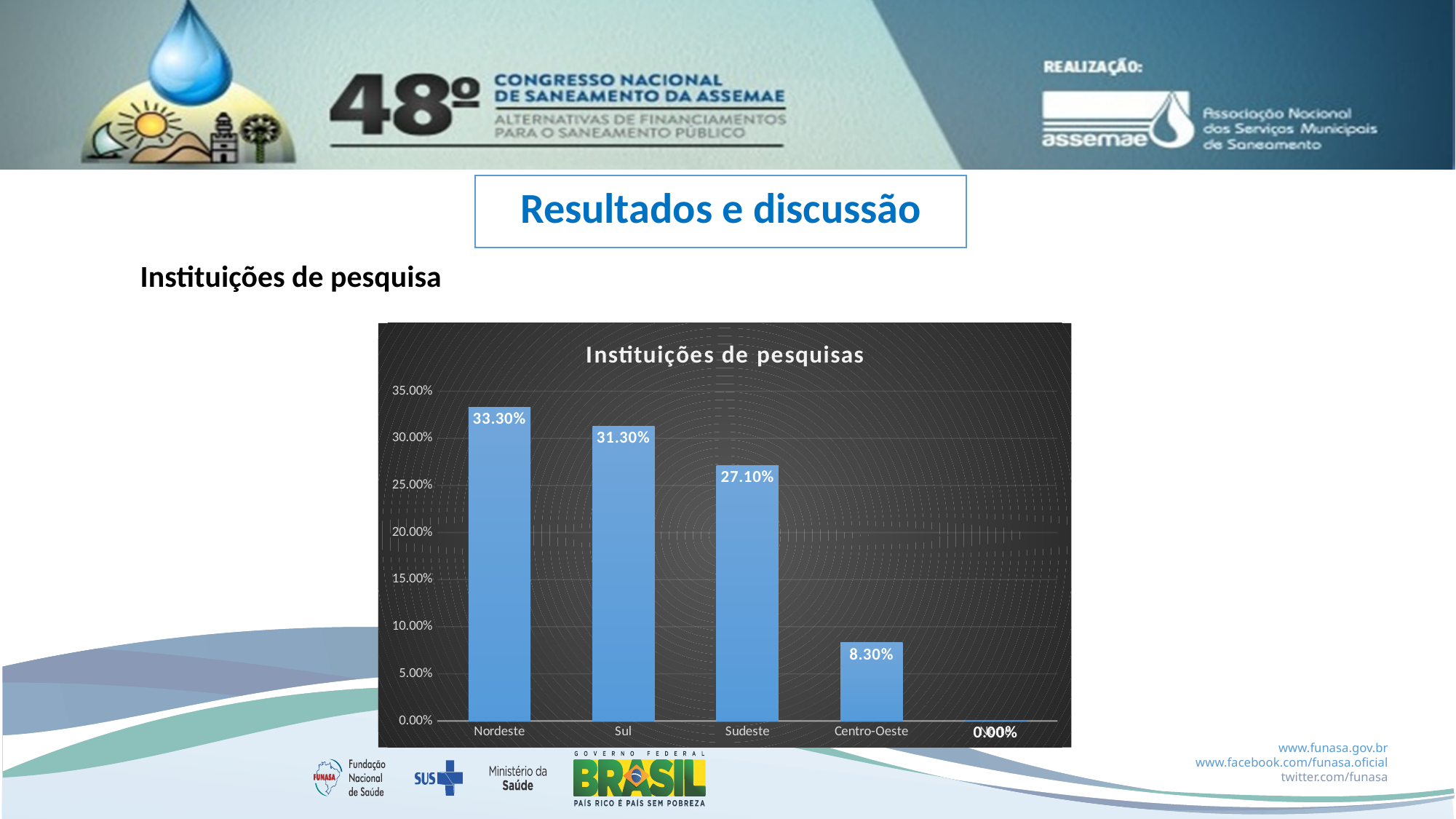
Which category has the highest value in the Instituições de pesquisas chart? Nordeste What is the value for Sudeste in the Instituições de pesquisas chart? 27.10% What is the title of the chart on the slide? Instituições de pesquisas Is the value for Centro-Oeste greater or less than 10.00% in the Instituições de pesquisas chart? less What is the value for Centro-Oeste in the Instituições de pesquisas chart? 8.30% What is the difference between the values for Sudeste and Centro-Oeste in the Instituições de pesquisas chart? 18.80% What is the difference between the values for Nordeste and Sul in the Instituições de pesquisas chart? 2.00% What is the value for Sul in the Instituições de pesquisas chart? 31.30% Which is larger in the Instituições de pesquisas chart, Sul or Sudeste? Sul Is the value for Sul greater or less than 30.00% in the Instituições de pesquisas chart? greater What is the value for Nordeste in the Instituições de pesquisas chart? 33.30% What kind of chart is shown on the slide? bar chart